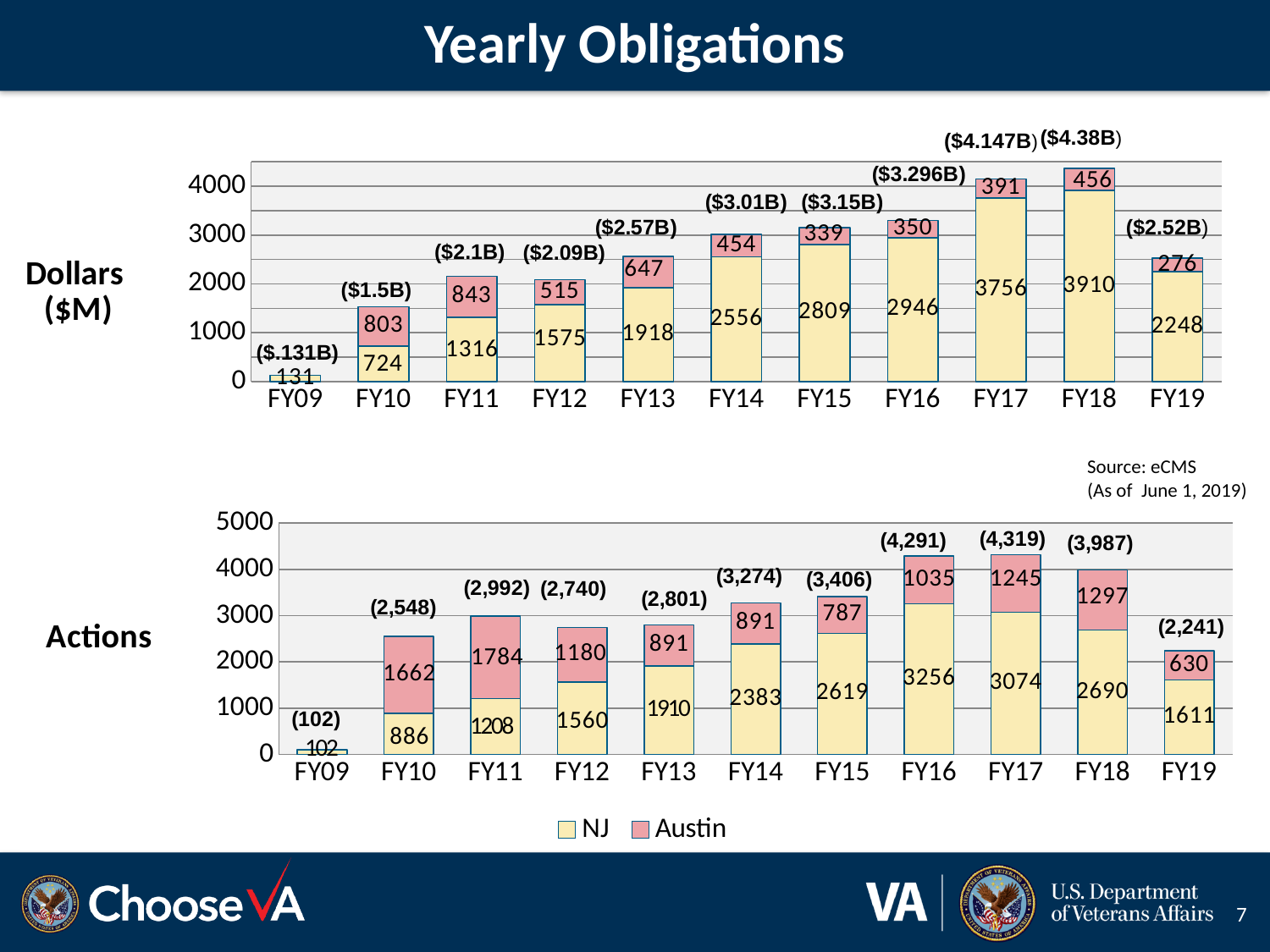
In the Actions chart, which is larger: the NJ value for FY15 or the NJ value for FY18? FY18 In the Actions chart, what is the total of the FY12 bar? 2,740 In the Dollars ($M) chart, what is the total labeled above the FY17 bar? ($4.147B) In the Actions chart, what is the Austin value for FY17? 1245 In the Dollars ($M) chart, what is the NJ value for FY18? 3910 In the Dollars ($M) chart, what is the difference between the NJ values for FY17 and FY16? 810 In the Dollars ($M) chart, which fiscal year has the highest NJ value? FY18 In the Actions chart, which fiscal year has the lowest total? FY09 In the Dollars ($M) chart, do the NJ values rise or fall from FY09 to FY18? Rise How many series does the legend list? 2 How many fiscal years are shown on the x axis of the Actions chart? 11 What kind of chart is the Actions chart? Stacked bar chart